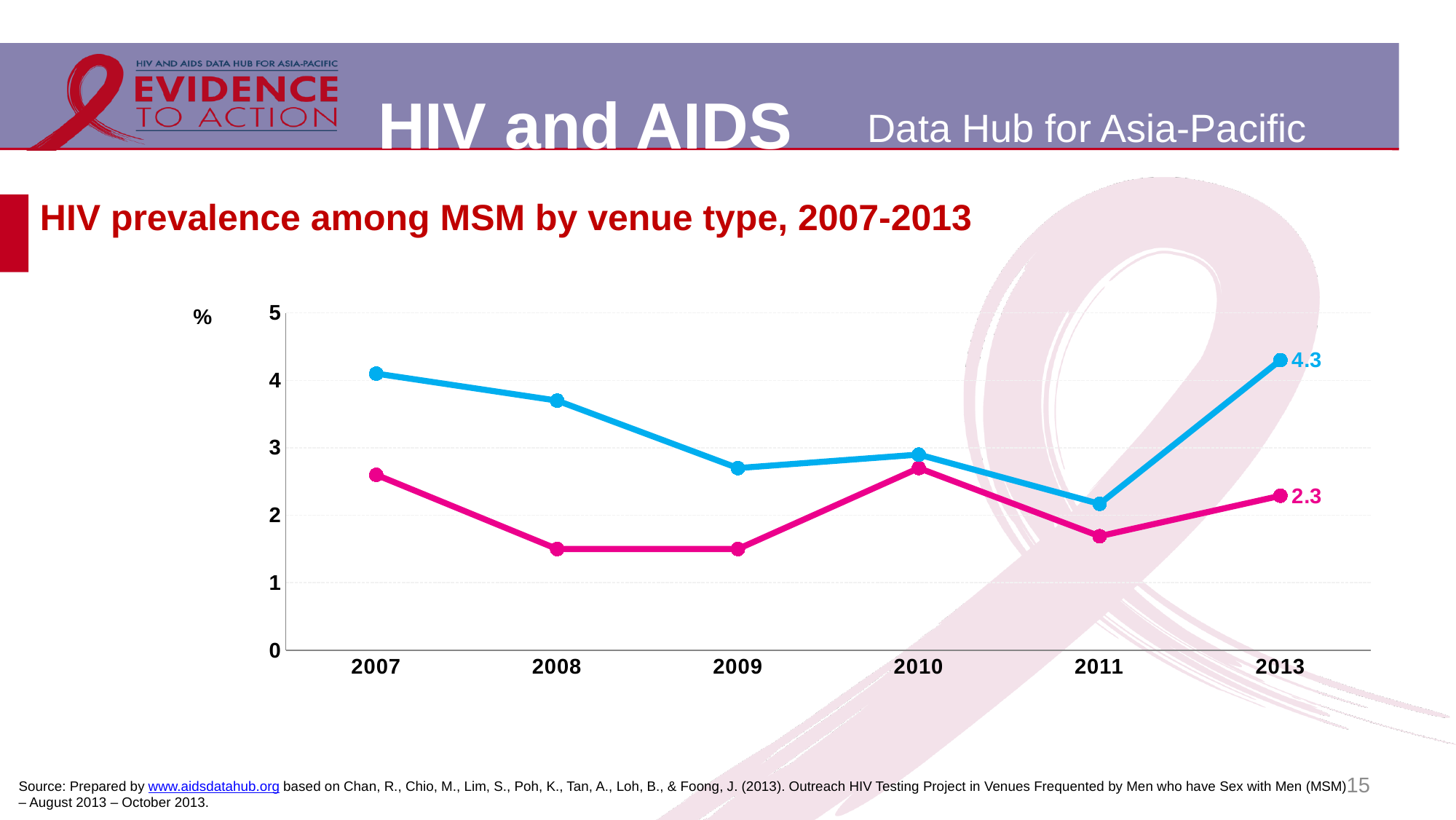
How many years are plotted along the x axis? 6 In which year does the blue line reach its lowest value? 2011 Does the blue line rise or fall from 2007 to 2011? fall What is the value of the pink line in 2013? 2.3 In 2013, which line has the higher value, the blue line or the pink line? blue line Is the value of the blue line in 2008 greater or less than 3? greater What is the difference between the blue line and the pink line in 2013? 2.0 What kind of chart is shown on the slide? line chart How many lines are plotted on the chart? 2 Is the value of the pink line in 2008 greater or less than 2? less What is the title of the chart? HIV prevalence among MSM by venue type, 2007-2013 What is the value of the blue line in 2013? 4.3